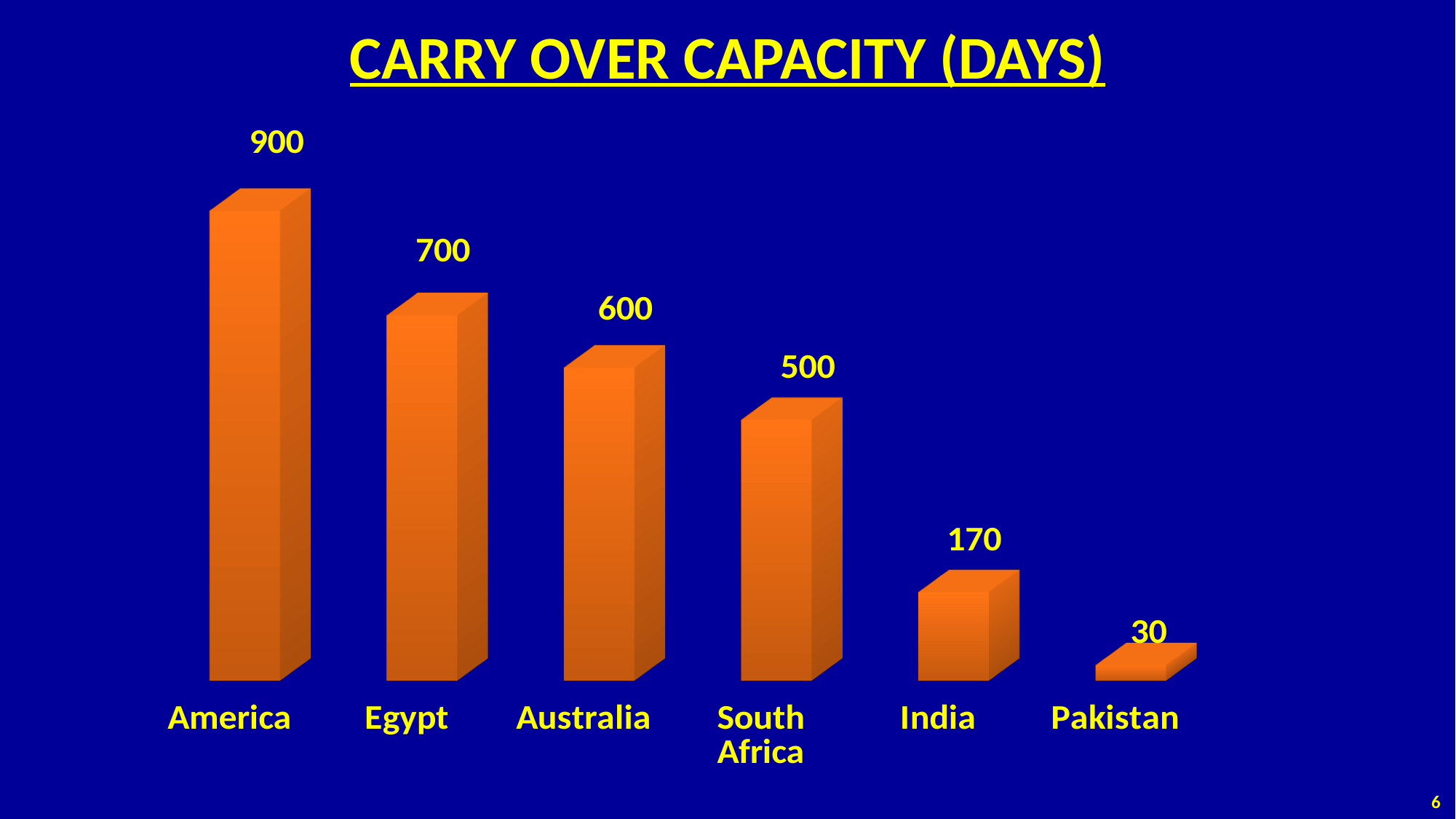
What kind of chart is shown on the slide? Bar chart What is the carry over capacity in days for Pakistan? 30 Which country has the highest carry over capacity? America What is the carry over capacity in days for Egypt? 700 Do the values rise or fall from left to right across the chart? Fall Which country has the lowest carry over capacity? Pakistan Which has a larger carry over capacity, Egypt or Australia? Egypt What is the carry over capacity in days for India? 170 What is the difference in carry over capacity between Australia and South Africa? 100 What is the difference in carry over capacity between India and Pakistan? 140 How many countries are shown in the chart? 6 What is the carry over capacity in days for America? 900